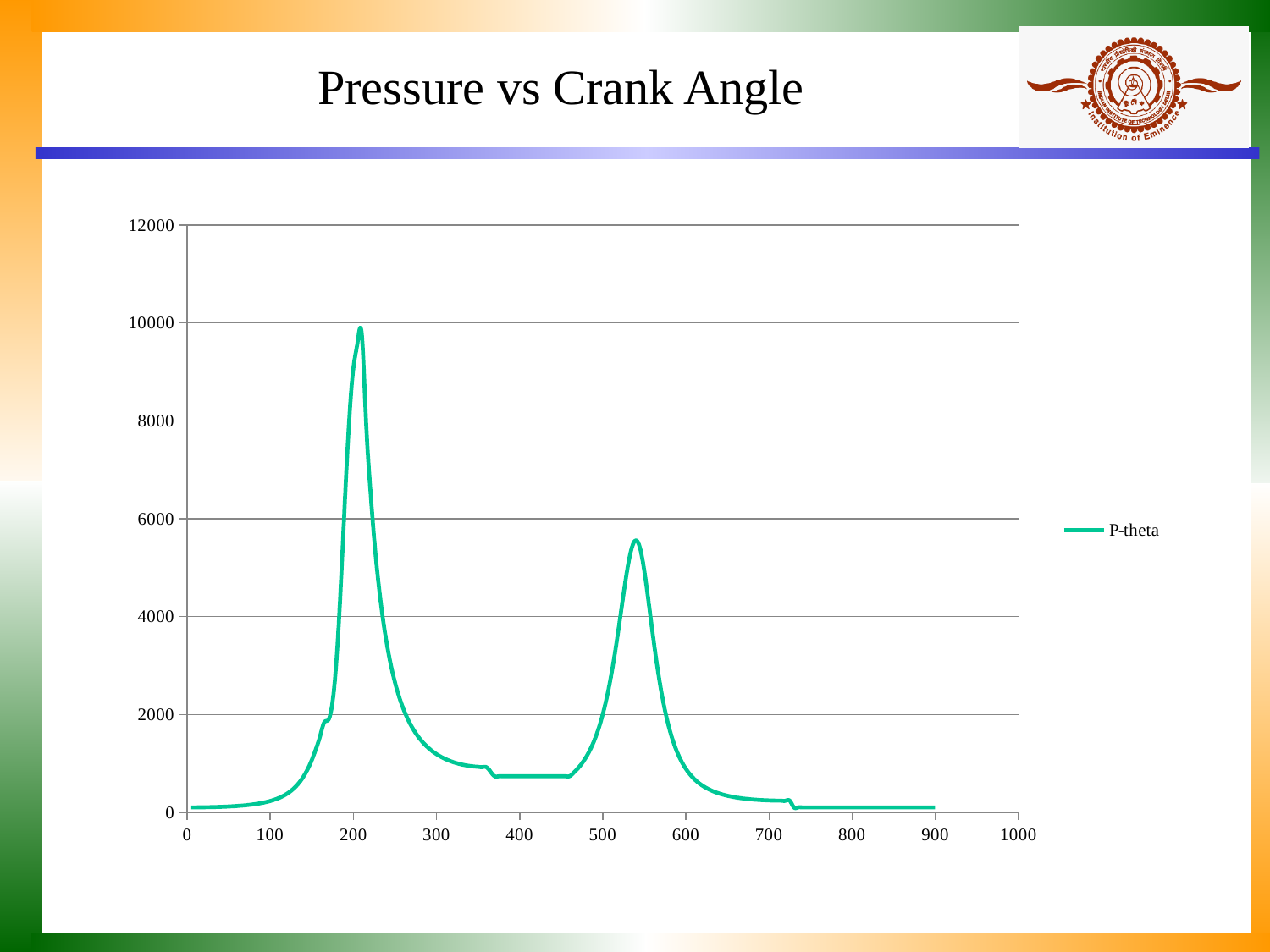
What kind of chart is shown on the slide? line chart Between crank angles of 100 and 200, does the P-theta value rise or fall? rise Between crank angles of 200 and 300, does the P-theta value rise or fall? fall Which is larger: the P-theta peak near a crank angle of 200 or the peak near a crank angle of 540? the peak near 200 What is the name of the series shown in the legend? P-theta Is the peak value of P-theta near a crank angle of 540 greater or less than 4000? greater Is the peak value of P-theta near a crank angle of 200 greater or less than 8000? greater Is the peak value of P-theta near a crank angle of 540 greater or less than 6000? less How many series does the legend list? 1 What is the title of the chart? Pressure vs Crank Angle